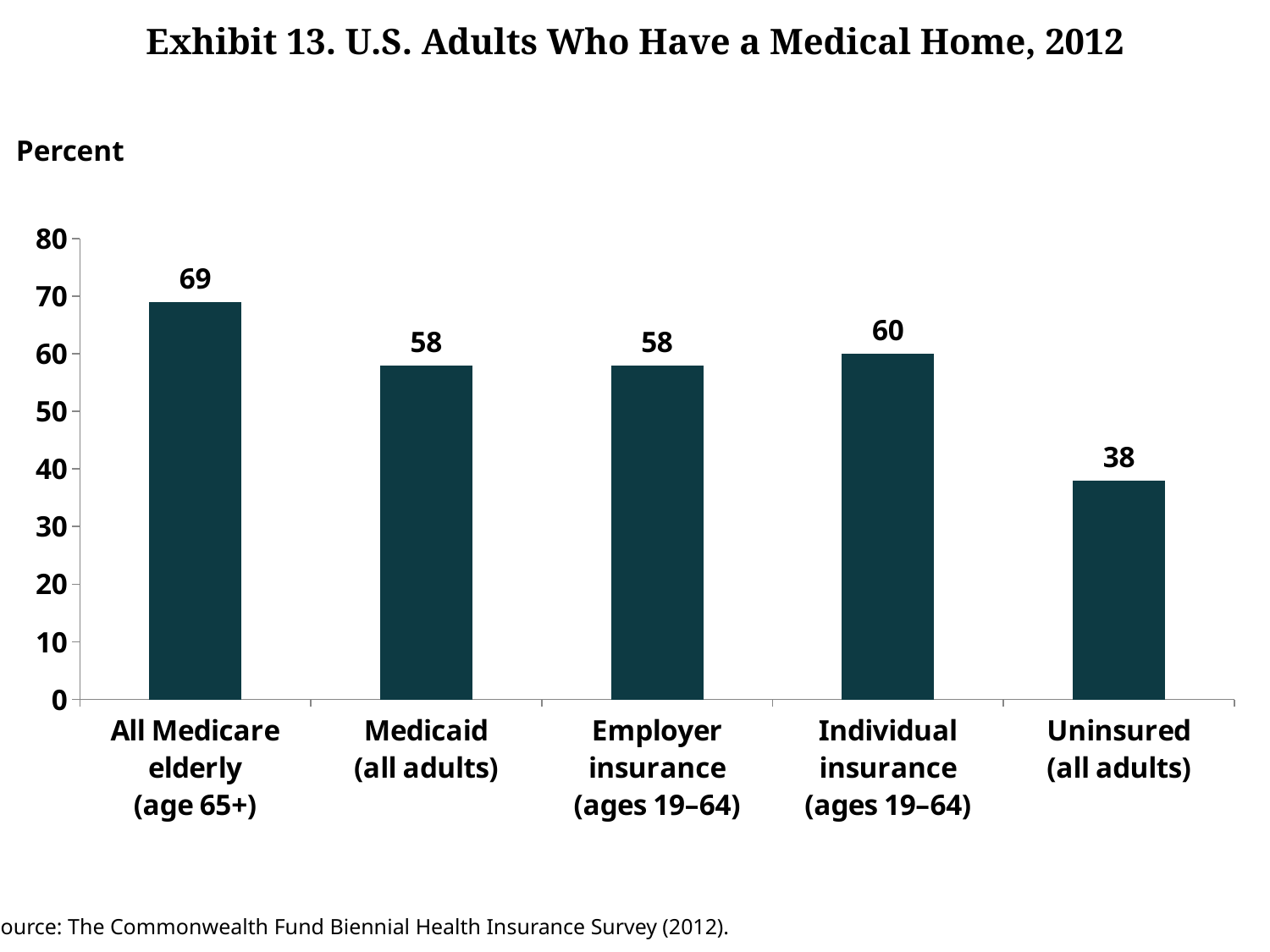
What is the difference between the values for All Medicare elderly (age 65+) and Uninsured (all adults)? 31 What is the value for Medicaid (all adults)? 58 What is the value for Individual insurance (ages 19–64)? 60 What is the value for Uninsured (all adults)? 38 What kind of chart is shown on the slide? Bar chart Which is larger, the value for All Medicare elderly (age 65+) or the value for Medicaid (all adults)? All Medicare elderly (age 65+) What is the value for All Medicare elderly (age 65+)? 69 How many categories are shown on the chart? 5 What is the difference between the values for Individual insurance (ages 19–64) and Employer insurance (ages 19–64)? 2 Which category has the lowest value? Uninsured (all adults) Which category has the highest value? All Medicare elderly (age 65+) What is the title of the chart? Exhibit 13. U.S. Adults Who Have a Medical Home, 2012